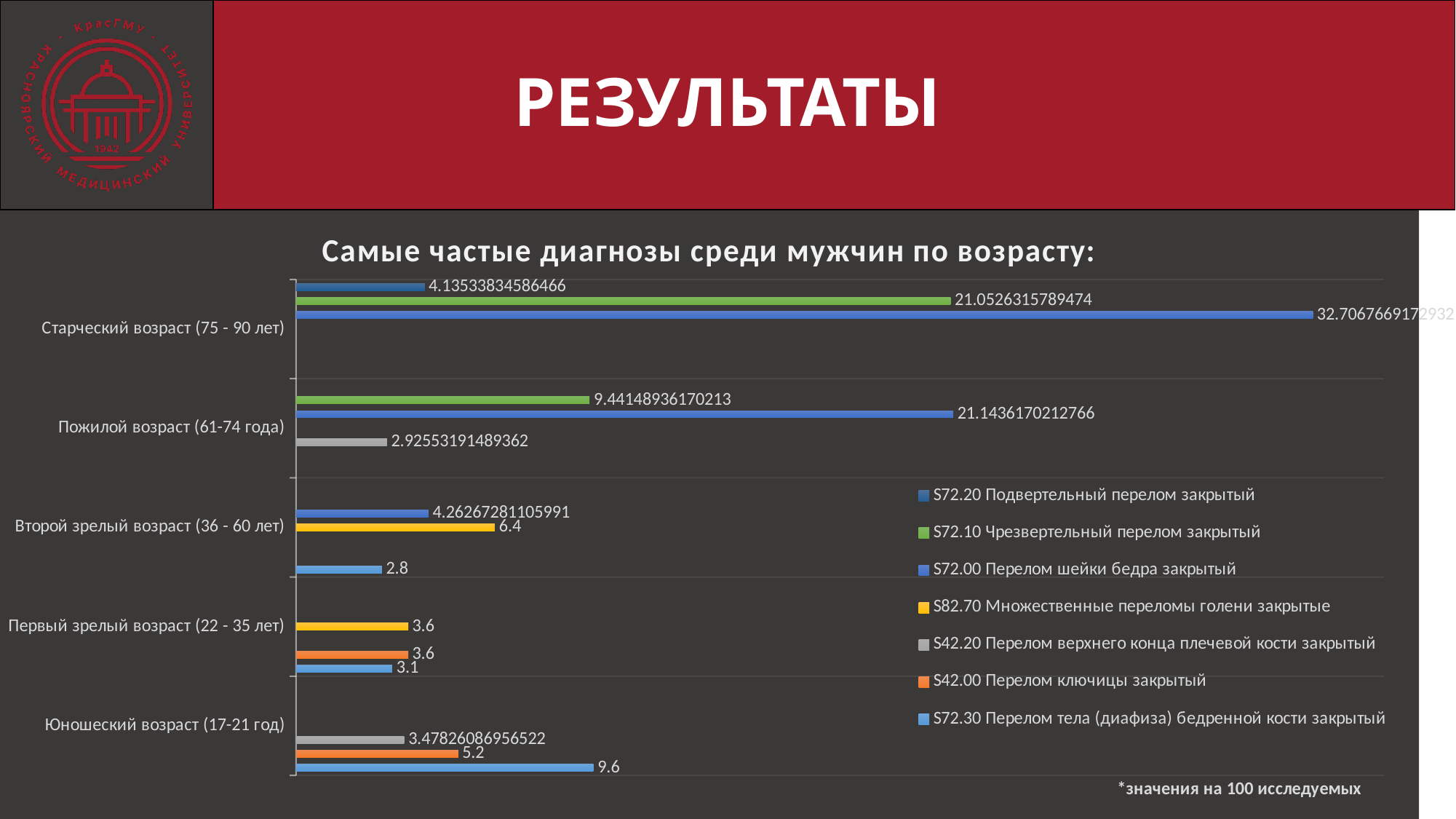
What is the value for S42.20 Перелом верхнего конца плечевой кости закрытый in the Пожилой возраст (61-74 года) group? 2.92553191489362 Which age group contains the longest bar on the chart? Старческий возраст (75 - 90 лет) In the Юношеский возраст (17-21 год) group, what is the difference between the values for S72.30 and S42.00? 4.4 Which diagnosis has the highest value in the Пожилой возраст (61-74 года) group? S72.00 Перелом шейки бедра закрытый What is the value for S82.70 Множественные переломы голени закрытые in the Второй зрелый возраст (36 - 60 лет) group? 6.4 What is the title of the chart? Самые частые диагнозы среди мужчин по возрасту: In the Второй зрелый возраст (36 - 60 лет) group, which is larger: S82.70 or S72.30? S82.70 How many age groups are shown on the chart? 5 What is the value for S72.30 Перелом тела (диафиза) бедренной кости закрытый in the Юношеский возраст (17-21 год) group? 9.6 What kind of chart is shown on the slide? Bar chart What is the value for S72.10 Чрезвертельный перелом закрытый in the Пожилой возраст (61-74 года) group? 9.44148936170213 How many series does the legend list? 7